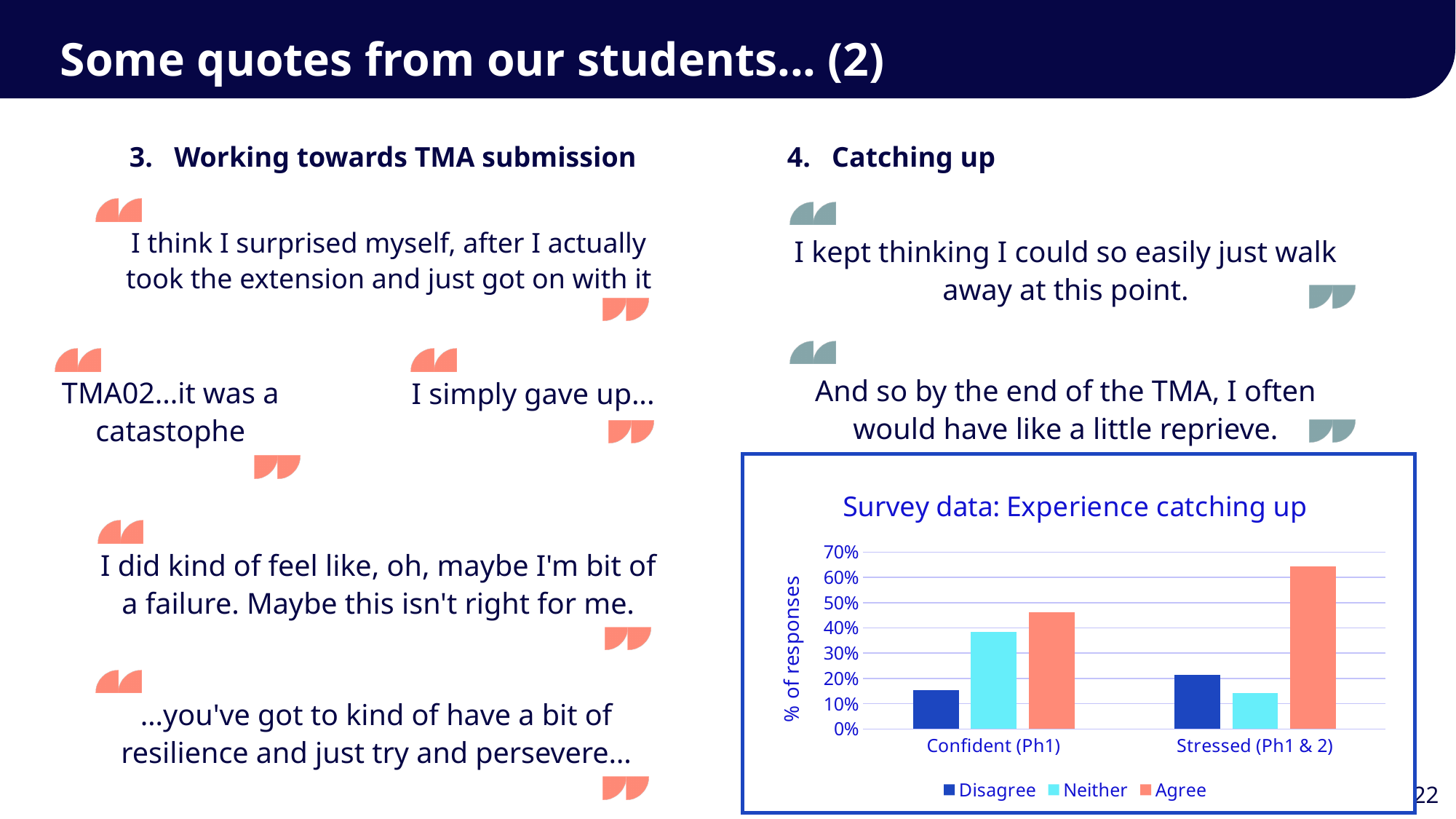
What is the title of the chart on the slide? Survey data: Experience catching up Which series has the lowest value for Confident (Ph1)? Disagree Is the Agree value for Stressed (Ph1 & 2) greater or less than 60%? greater How many series does the chart's legend list? 3 Which is larger: the Agree value for Confident (Ph1) or the Agree value for Stressed (Ph1 & 2)? Stressed (Ph1 & 2) Is the Neither value for Confident (Ph1) greater or less than 30%? greater Which series has the lowest value for Stressed (Ph1 & 2)? Neither What is the label of the y axis of the chart? % of responses Which series has the highest value for Stressed (Ph1 & 2)? Agree Is the Disagree value for Confident (Ph1) greater or less than 20%? less What type of chart is shown on the slide? bar chart How many categories are shown on the x axis of the chart? 2